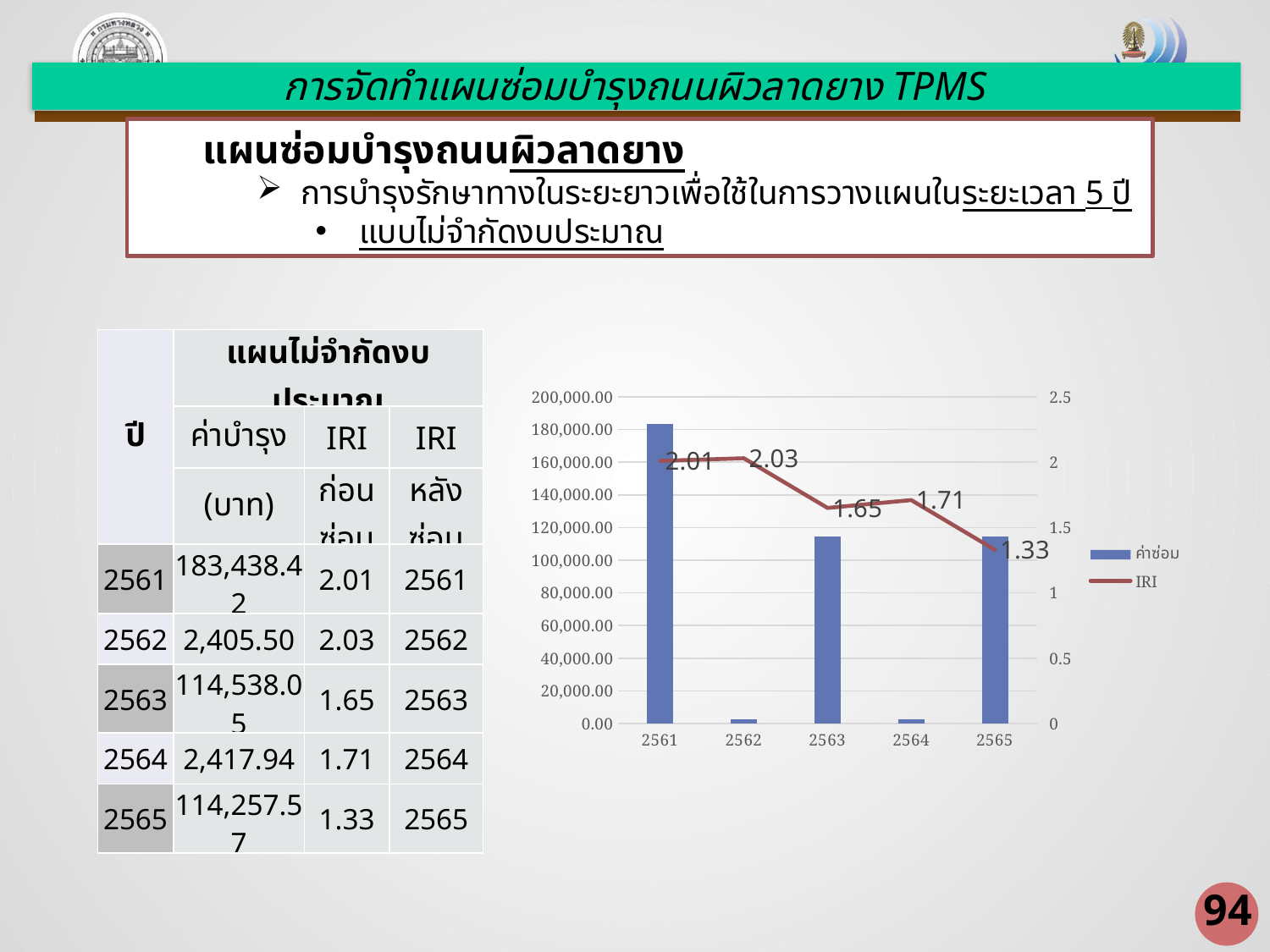
How many series does the chart legend list? 2 Which year has the lowest IRI value? 2565 Which year has the larger IRI value, 2563 or 2564? 2564 Is the ค่าซ่อม bar for 2563 greater or less than 120,000.00? less What is the IRI value for 2565? 1.33 Is the ค่าซ่อม bar for 2561 greater or less than 160,000.00? greater How many years are shown on the x axis of the chart? 5 What is the IRI value for 2561? 2.01 What is the IRI value for 2563? 1.65 What is the difference between the IRI values for 2562 and 2565? 0.70 Which year has the highest IRI value? 2562 Which year has the tallest ค่าซ่อม bar? 2561